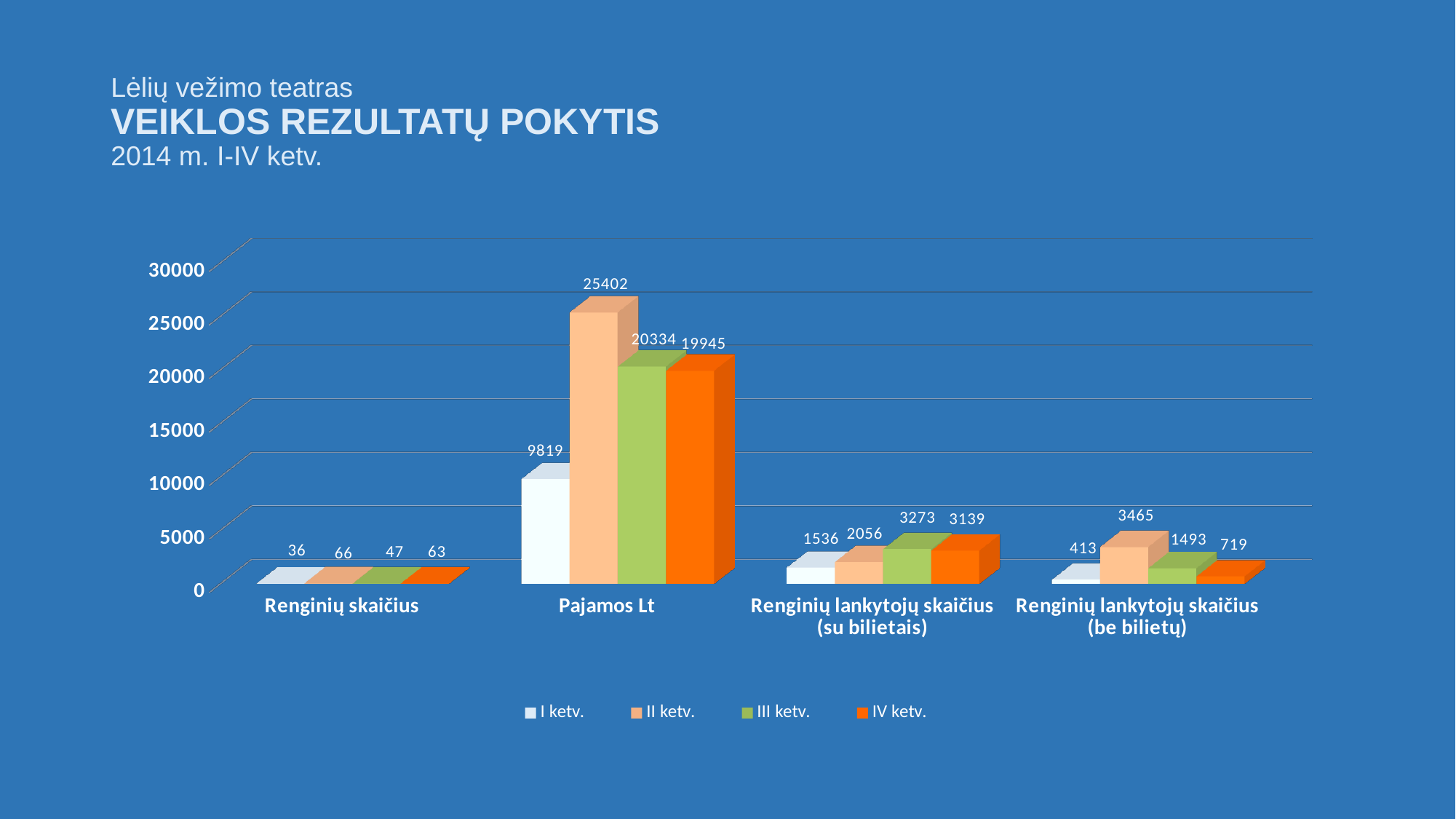
How many series does the legend list? 4 What is the value for I ketv. in the Renginių skaičius category? 36 What is the value for III ketv. in the Renginių lankytojų skaičius (su bilietais) category? 3273 Which is larger in the Renginių skaičius category: the II ketv. value or the IV ketv. value? II ketv. What is the difference between the II ketv. and I ketv. values in the Pajamos Lt category? 15583 What kind of chart is shown on the slide? Bar chart How many categories are shown on the x axis? 4 Which quarter has the highest value in the Pajamos Lt category? II ketv. What is the value for II ketv. in the Pajamos Lt category? 25402 Which quarter has the lowest value in the Renginių lankytojų skaičius (be bilietų) category? I ketv. What is the total of the four quarterly values in the Renginių skaičius category? 212 What is the value for IV ketv. in the Renginių lankytojų skaičius (be bilietų) category? 719